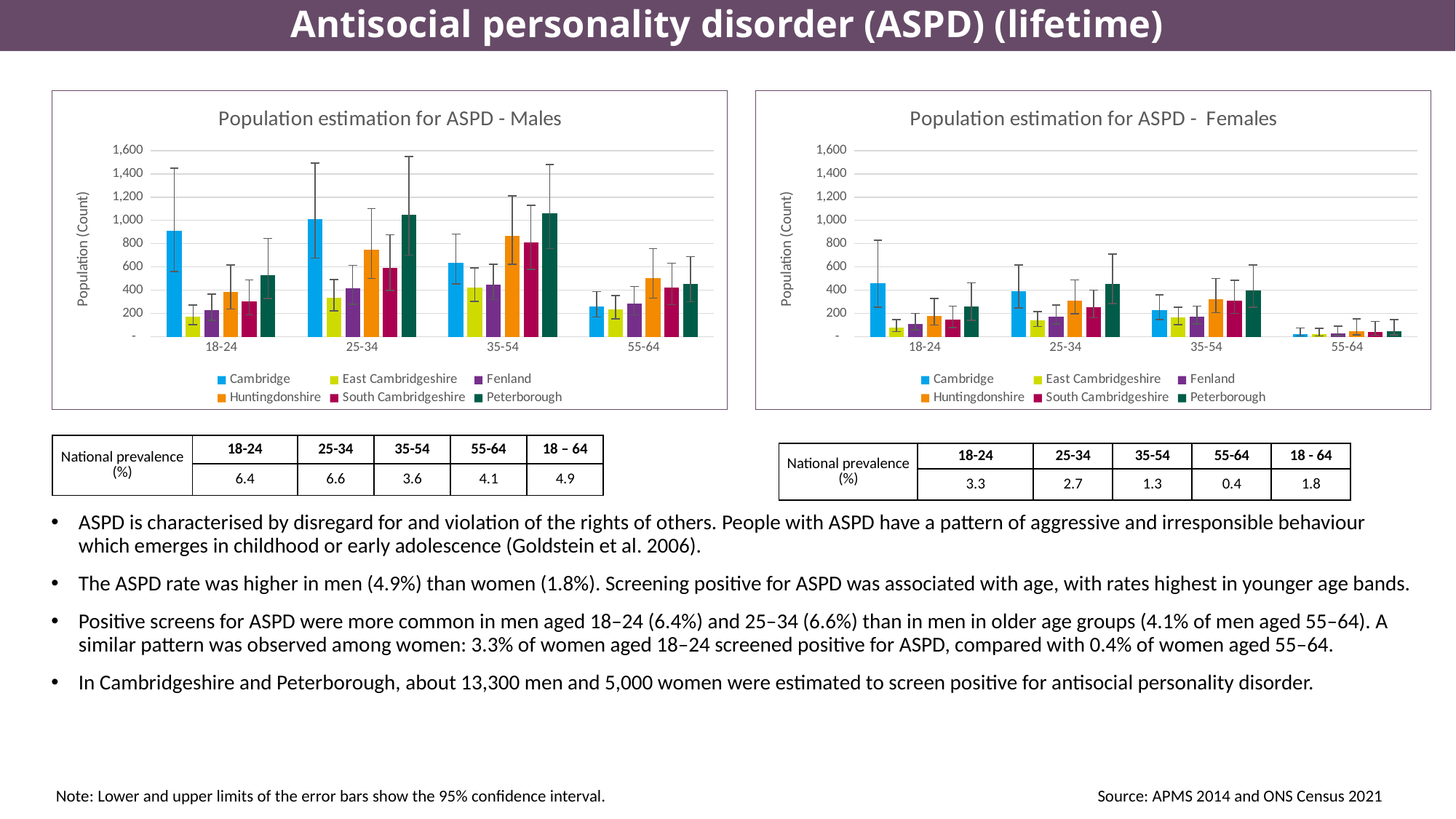
In the 'Population estimation for ASPD - Females' chart, in the 25-34 age band, which is larger: Huntingdonshire or East Cambridgeshire? Huntingdonshire In the 'Population estimation for ASPD - Females' chart, is the value for Cambridge in the 18-24 age band greater or less than 400? greater In the 'Population estimation for ASPD - Females' chart, how many age-band categories are shown on the x axis? 4 What kind of chart is the 'Population estimation for ASPD - Males' chart? bar chart In the 'Population estimation for ASPD - Males' chart, is the value for Cambridge in the 55-64 age band greater or less than 400? less In the 'Population estimation for ASPD - Males' chart, in the 35-54 age band, which is larger: Huntingdonshire or Fenland? Huntingdonshire In the 'Population estimation for ASPD - Females' chart, do the values for Cambridge rise or fall across the age bands from 18-24 to 55-64? fall In the 'Population estimation for ASPD - Males' chart, which area has the highest value in the 18-24 age band? Cambridge In the 'Population estimation for ASPD - Males' chart, which area has the lowest value in the 18-24 age band? East Cambridgeshire What is the y-axis title of the 'Population estimation for ASPD - Females' chart? Population (Count) In the 'Population estimation for ASPD - Males' chart, how many series does the legend list? 6 In the 'Population estimation for ASPD - Males' chart, is the value for Cambridge in the 25-34 age band greater or less than 800? greater